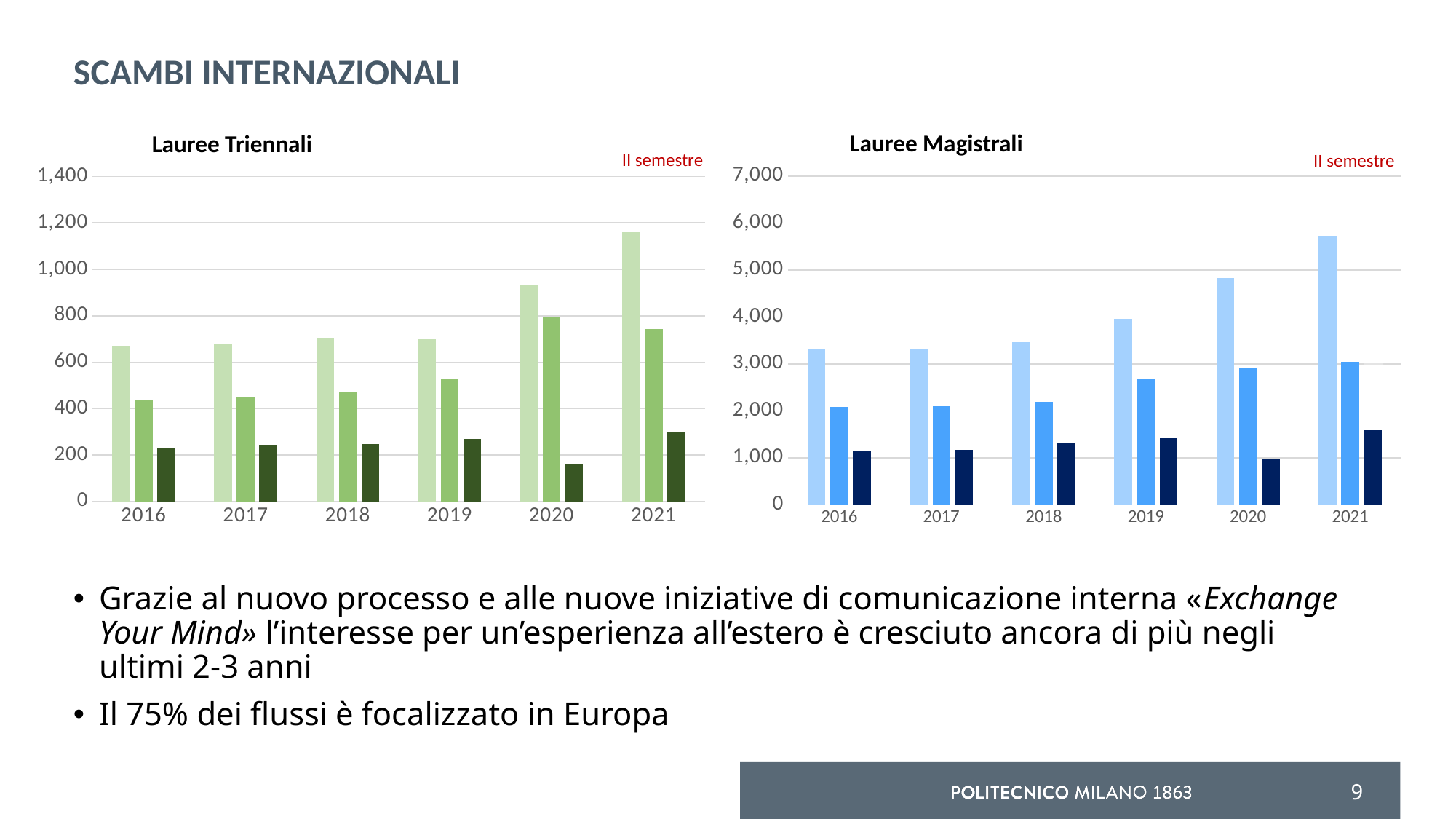
In the Lauree Triennali chart, is the medium green bar taller in 2020 or in 2021? 2020 In the Lauree Magistrali chart, which year has the lowest dark blue bar? 2020 What red annotation text appears at the top right of each chart? II semestre In the Lauree Magistrali chart, which year has the tallest light blue bar? 2021 In the Lauree Magistrali chart, do the light blue bars rise or fall from 2016 to 2021? rise In the Lauree Magistrali chart, is the dark blue bar for 2016 greater or less than 2,000? less In the Lauree Magistrali chart, is the light blue bar for 2021 greater or less than 5,000? greater In the Lauree Triennali chart, which year has the lowest dark green bar? 2020 In the Lauree Triennali chart, which year has the tallest light green bar? 2021 How many years are shown on the x axis of the Lauree Magistrali chart? 6 What kind of chart is the Lauree Triennali chart? bar chart In the Lauree Triennali chart, is the light green bar for 2021 greater or less than 1,000? greater